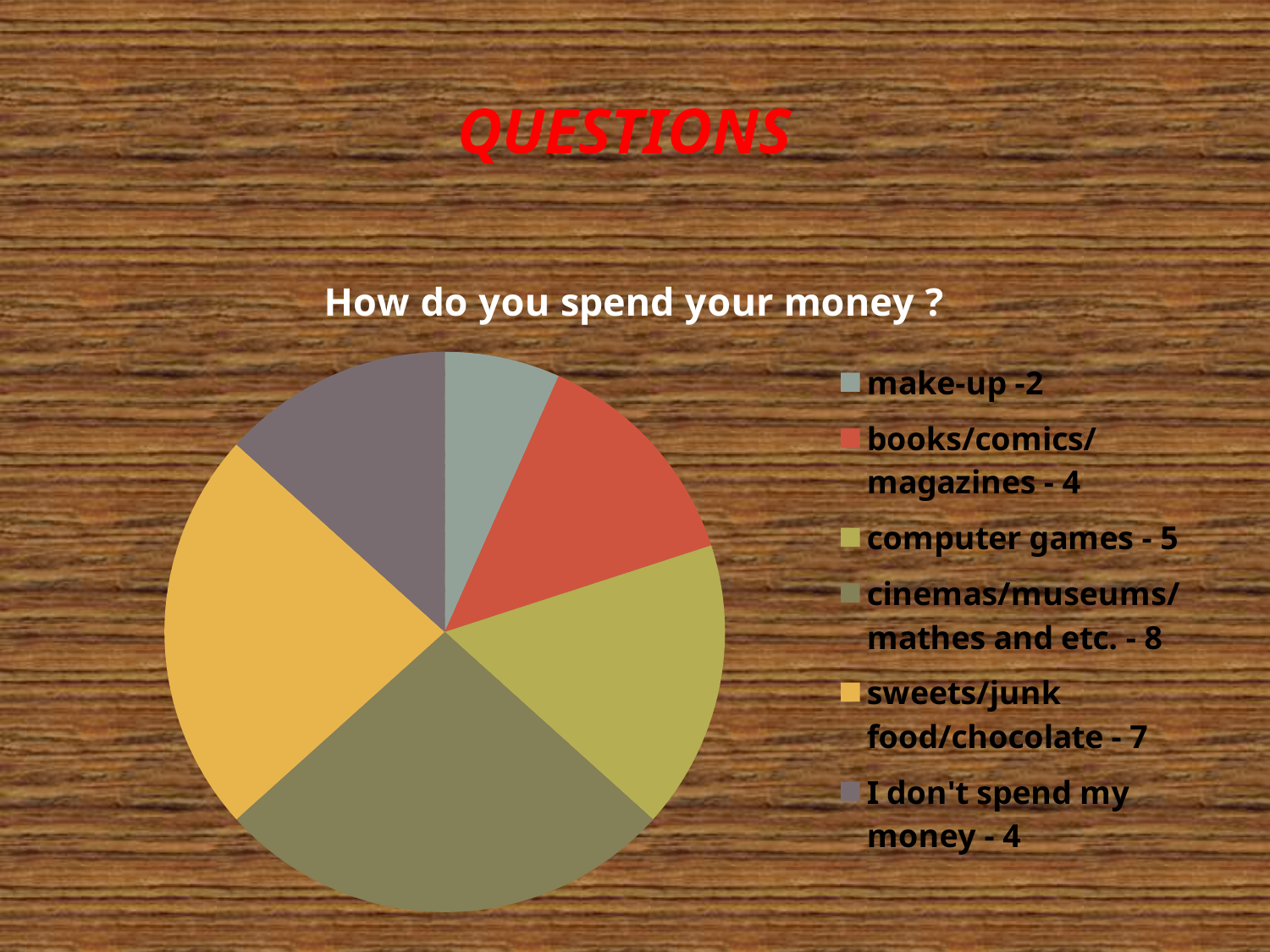
Which category has the smallest slice of the pie? make-up What is the value for make-up? 2 What is the difference between the value for cinemas/museums/mathes and etc. and the value for make-up? 6 What is the title of the chart? How do you spend your money ? What kind of chart is shown on the slide? pie chart What is the value for computer games? 5 How many categories does the pie chart have? 6 What is the value for sweets/junk food/chocolate? 7 Which is larger, the value for sweets/junk food/chocolate or the value for computer games? sweets/junk food/chocolate Which category has the largest slice of the pie? cinemas/museums/mathes and etc. What is the value for cinemas/museums/mathes and etc.? 8 What is the total of all the values shown in the legend? 30